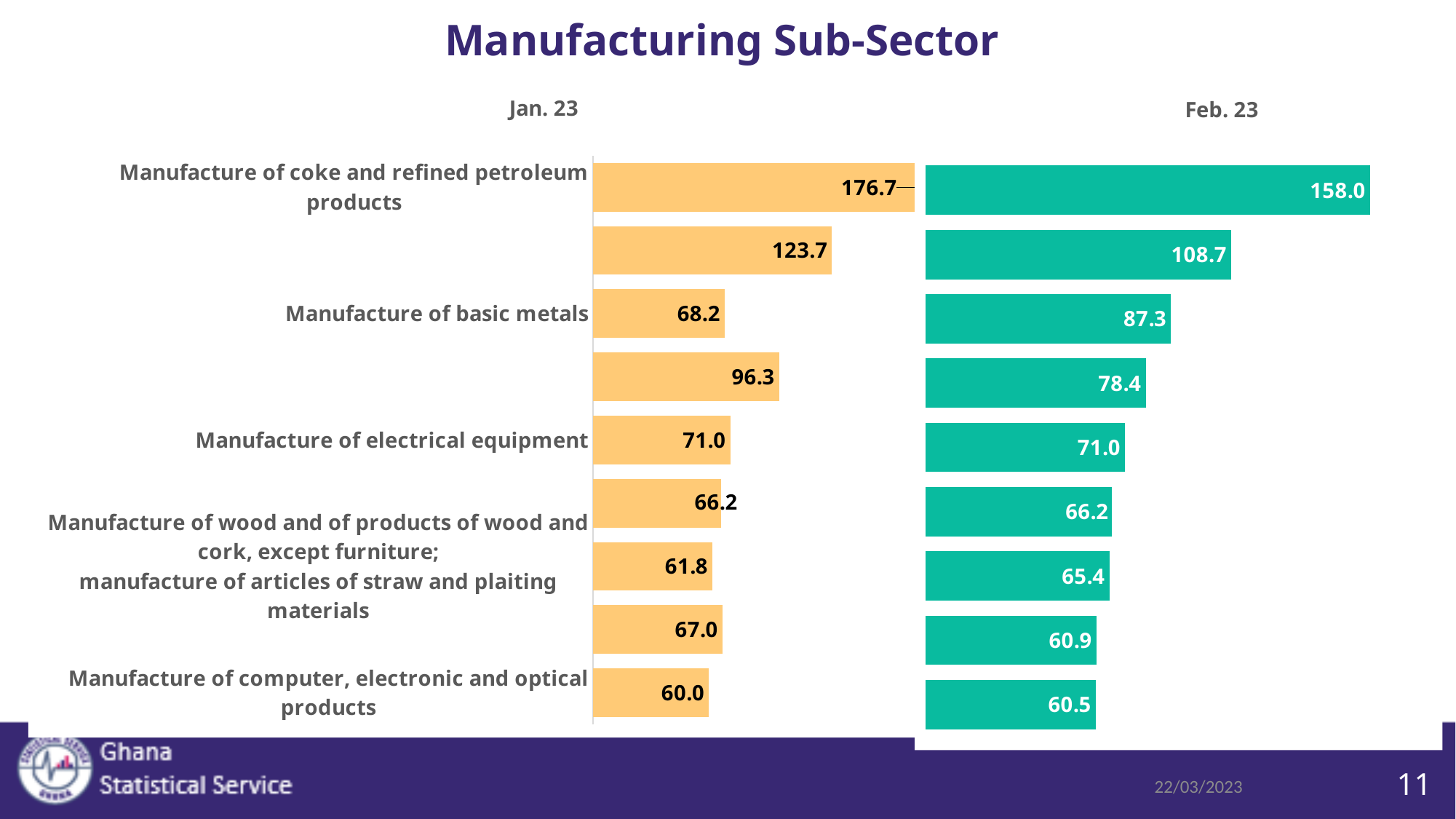
In the Jan. 23 chart, what is the value for Manufacture of coke and refined petroleum products? 176.7 In the Jan. 23 chart, what is the value for Manufacture of computer, electronic and optical products? 60.0 In the Feb. 23 chart, which category has the highest value? Manufacture of coke and refined petroleum products In the Jan. 23 chart, what is the value for Manufacture of electrical equipment? 71.0 In the Feb. 23 chart, what is the value for Manufacture of basic metals? 87.3 For Manufacture of basic metals, which is larger: the Jan. 23 value or the Feb. 23 value? Feb. 23 What is the difference between the Feb. 23 and Jan. 23 values for Manufacture of basic metals? 19.1 In the Jan. 23 chart, which category has the highest value? Manufacture of coke and refined petroleum products In the Feb. 23 chart, what is the value for Manufacture of computer, electronic and optical products? 60.5 How much higher is the Jan. 23 value for Manufacture of coke and refined petroleum products than the Feb. 23 value? 18.7 In the Jan. 23 chart, which category has the lowest value? Manufacture of computer, electronic and optical products How many bars are shown in the Jan. 23 chart? 9